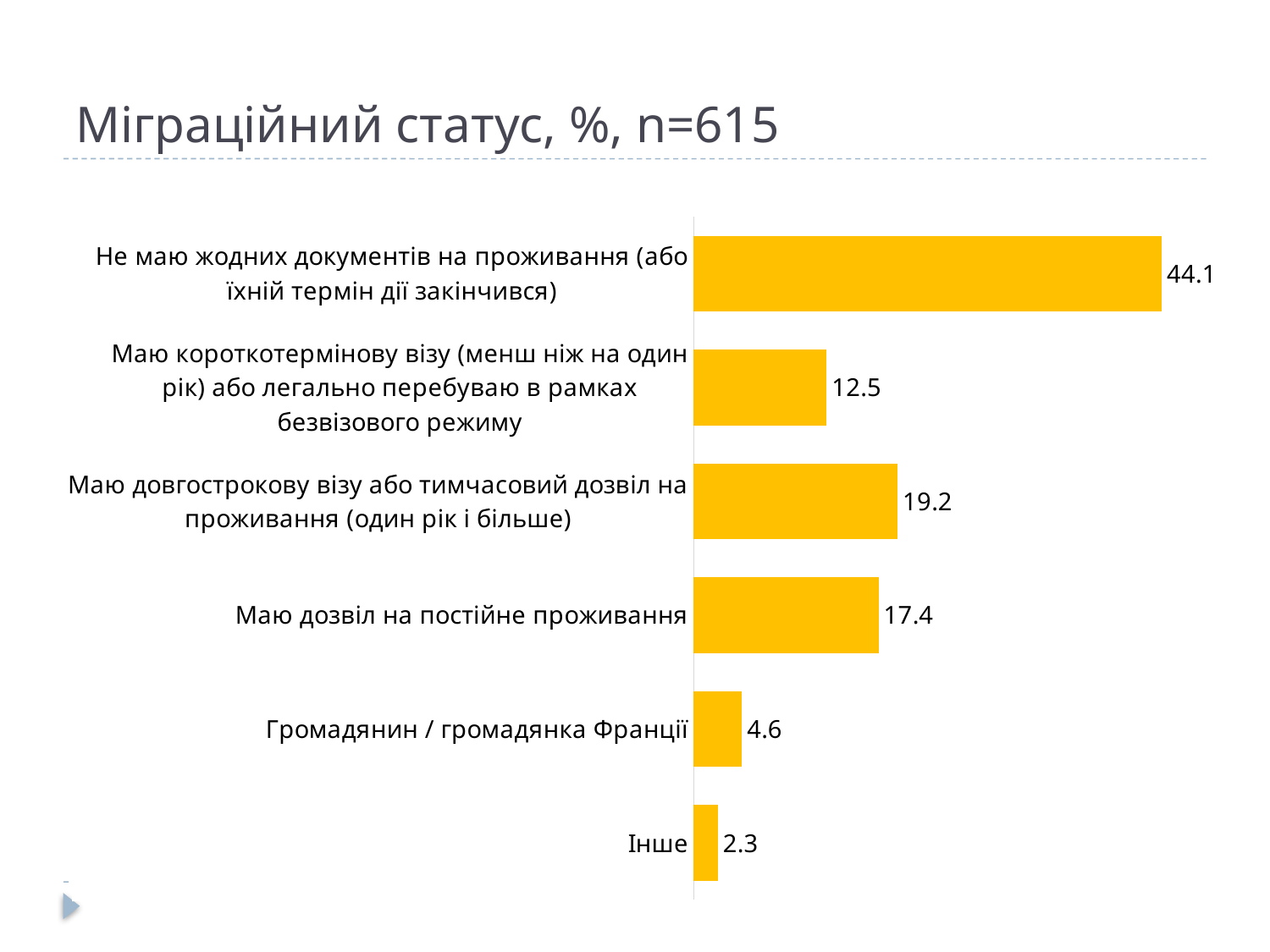
What is the value for "Не маю жодних документів на проживання (або їхній термін дії закінчився)"? 44.1 What is the value for "Громадянин / громадянка Франції"? 4.6 What is the value for "Інше"? 2.3 What is the difference between the values for "Маю довгострокову візу або тимчасовий дозвіл на проживання (один рік і більше)" and "Маю короткотермінову візу (менш ніж на один рік) або легально перебуваю в рамках безвізового режиму"? 6.7 Which is larger: the value for "Маю дозвіл на постійне проживання" or the value for "Маю короткотермінову візу (менш ніж на один рік) або легально перебуваю в рамках безвізового режиму"? Маю дозвіл на постійне проживання Which category has the highest value? Не маю жодних документів на проживання (або їхній термін дії закінчився) What colour are the bars in the chart? Yellow What is the title of the chart? Міграційний статус, %, n=615 How many categories are shown in the chart? 6 Which category has the lowest value? Інше What kind of chart is shown on the slide? Bar chart What is the value for "Маю дозвіл на постійне проживання"? 17.4